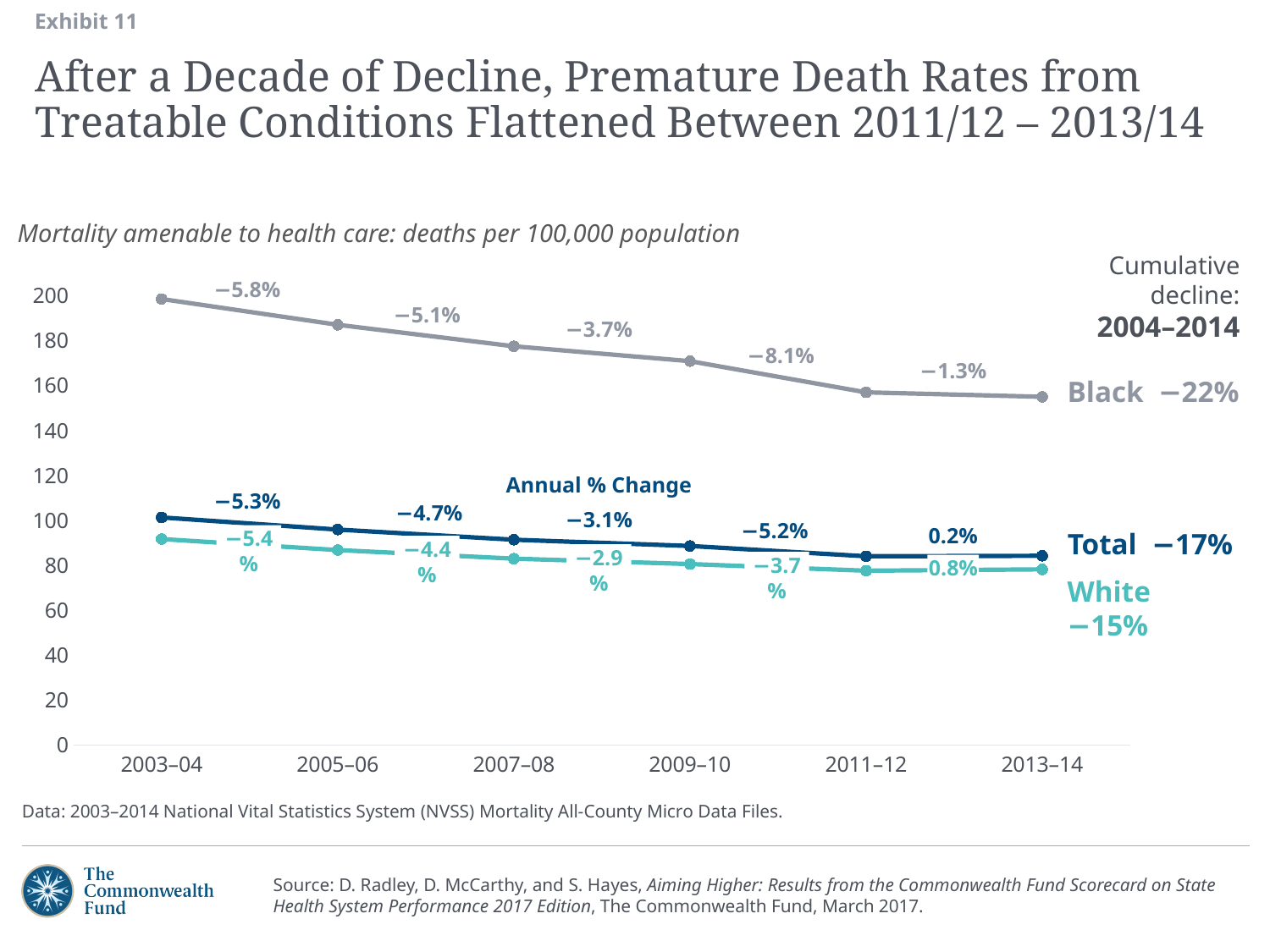
Which series has the highest mortality rate across all periods? Black How many time periods are shown along the x axis? 6 What is the cumulative decline for Total from 2004–2014? −17% What is the cumulative decline for Black from 2004–2014? −22% What is the cumulative decline for White from 2004–2014? −15% What is the annual % change for the Black line between 2009–10 and 2011–12? −8.1% How many lines (series) are plotted on the chart? 3 Is the Black mortality rate in 2003–04 greater or less than 180? greater Is the White mortality rate in 2013–14 greater or less than 100? less What is the annual % change for the Total line between 2011–12 and 2013–14? 0.2% Does the Black line rise or fall from 2003–04 to 2013–14? Fall What kind of chart is shown on the slide? Line chart